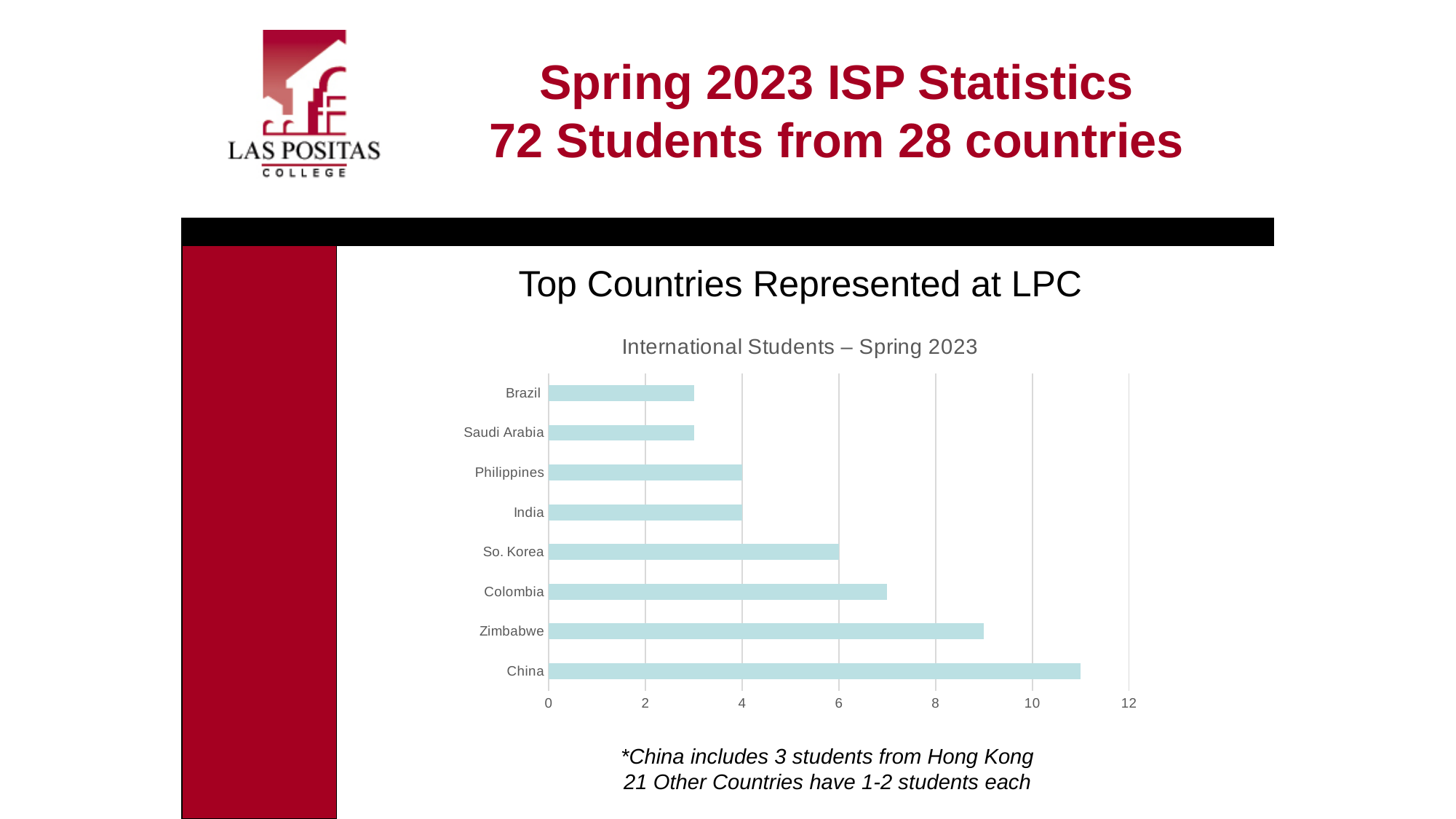
Which has more international students, China or Zimbabwe? China What is the title of the chart? International Students – Spring 2023 Is the value for China greater or less than 10? greater Is the value for Brazil greater or less than 4? less What is the difference between the number of students from So. Korea and from India? 2 How many international students are from India? 4 How many international students are from So. Korea? 6 How many international students are from the Philippines? 4 How many countries are shown in the chart? 8 Is the value for Zimbabwe greater or less than 8? greater Which country has the highest number of international students in the chart? China What type of chart is shown on the slide? bar chart